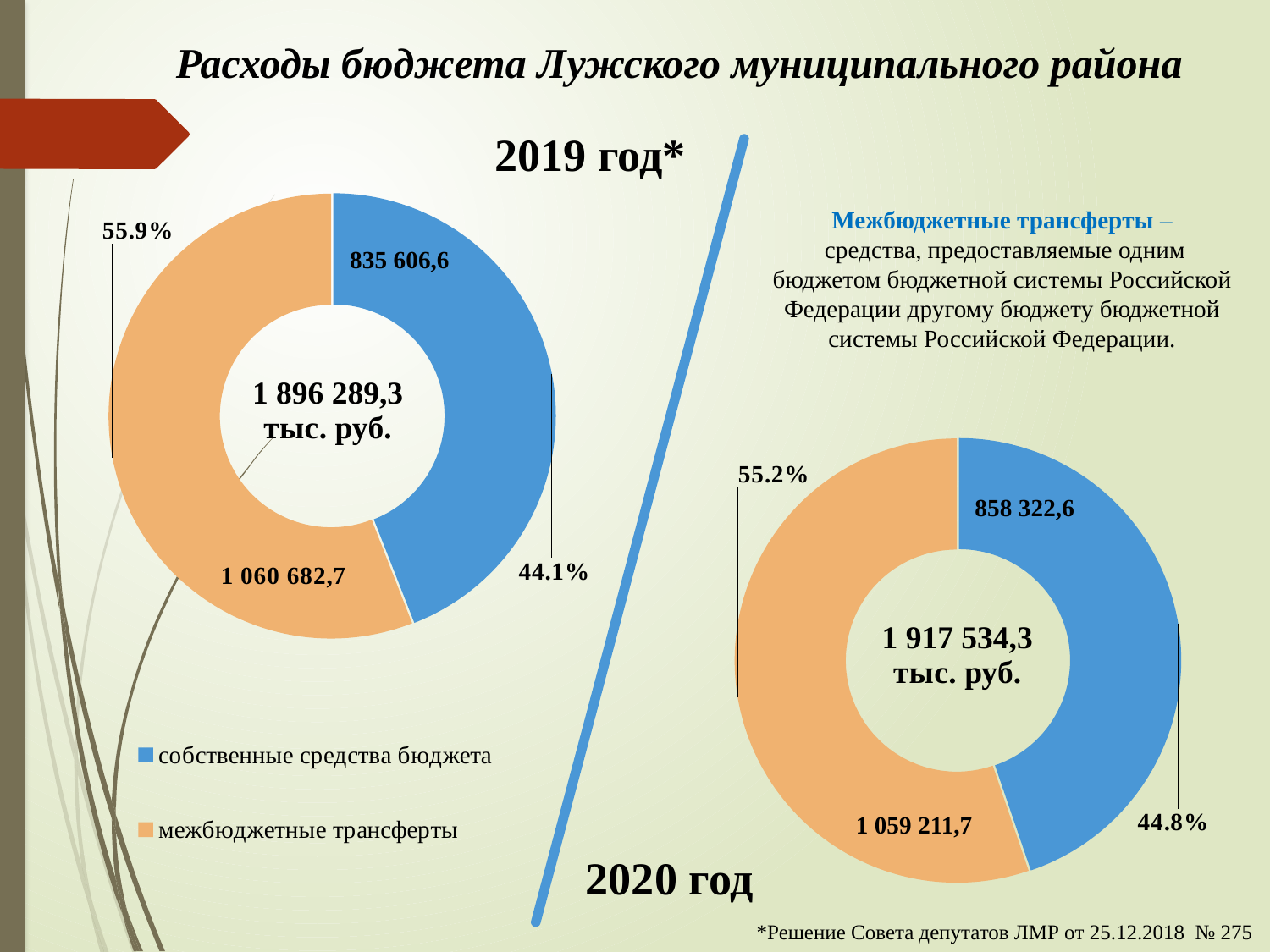
In the 2019 год* chart, what is the value for межбюджетные трансферты? 1 060 682,7 In the 2020 год chart, what is the value for межбюджетные трансферты? 1 059 211,7 In the 2019 год* chart, what share of the total do межбюджетные трансферты make up? 55.9% In the 2020 год chart, what share of the total do собственные средства бюджета make up? 44.8% In the 2019 год* chart, which category is the largest? межбюджетные трансферты In the 2020 год chart, which is larger: собственные средства бюджета or межбюджетные трансферты? межбюджетные трансферты What total is shown in the centre of the 2020 год chart? 1 917 534,3 тыс. руб. What kind of chart is used for the 2019 год* data? Donut (pie) chart How many categories does the legend list for the charts? 2 Which colour represents собственные средства бюджета in the charts? Blue In the 2020 год chart, what is the value for собственные средства бюджета? 858 322,6 In the 2019 год* chart, what is the value for собственные средства бюджета? 835 606,6